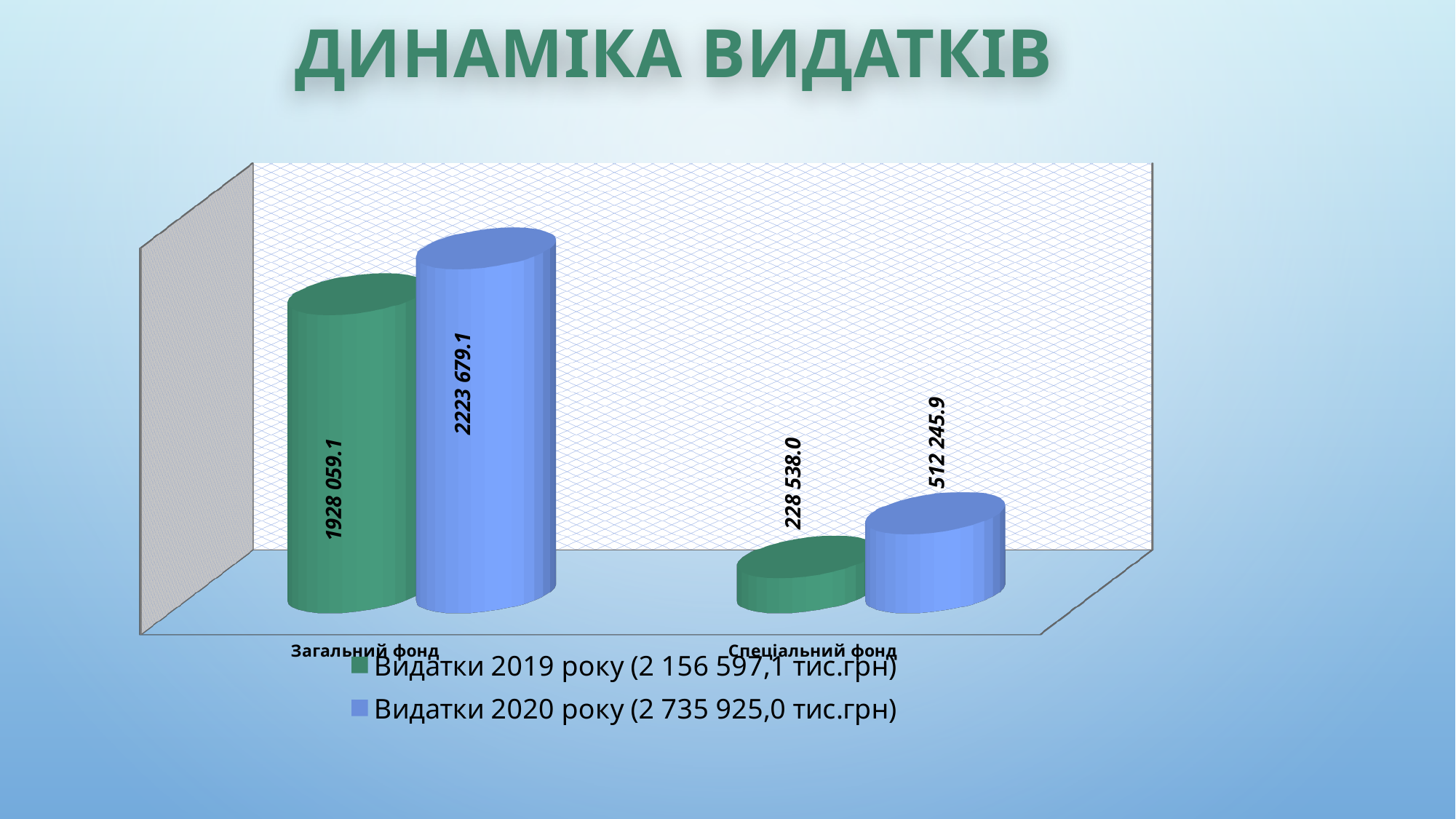
Which category has the highest value in the Видатки 2020 року series? Загальний фонд What is the difference between the 2020 and 2019 values for Загальний фонд? 295 620.0 What is the value for Спеціальний фонд in the Видатки 2020 року series? 512 245.9 What is the value for Загальний фонд in the Видатки 2020 року series? 2223 679.1 How many categories are shown on the x axis? 2 What is the value for Спеціальний фонд in the Видатки 2019 року series? 228 538.0 What is the difference between the 2020 and 2019 values for Спеціальний фонд? 283 707.9 What is the value for Загальний фонд in the Видатки 2019 року series? 1928 059.1 For Спеціальний фонд, which is larger: the Видатки 2019 року value or the Видатки 2020 року value? Видатки 2020 року How many series does the legend list? 2 What is the title of the chart? ДИНАМІКА ВИДАТКІВ Which category has the lowest value in the Видатки 2019 року series? Спеціальний фонд